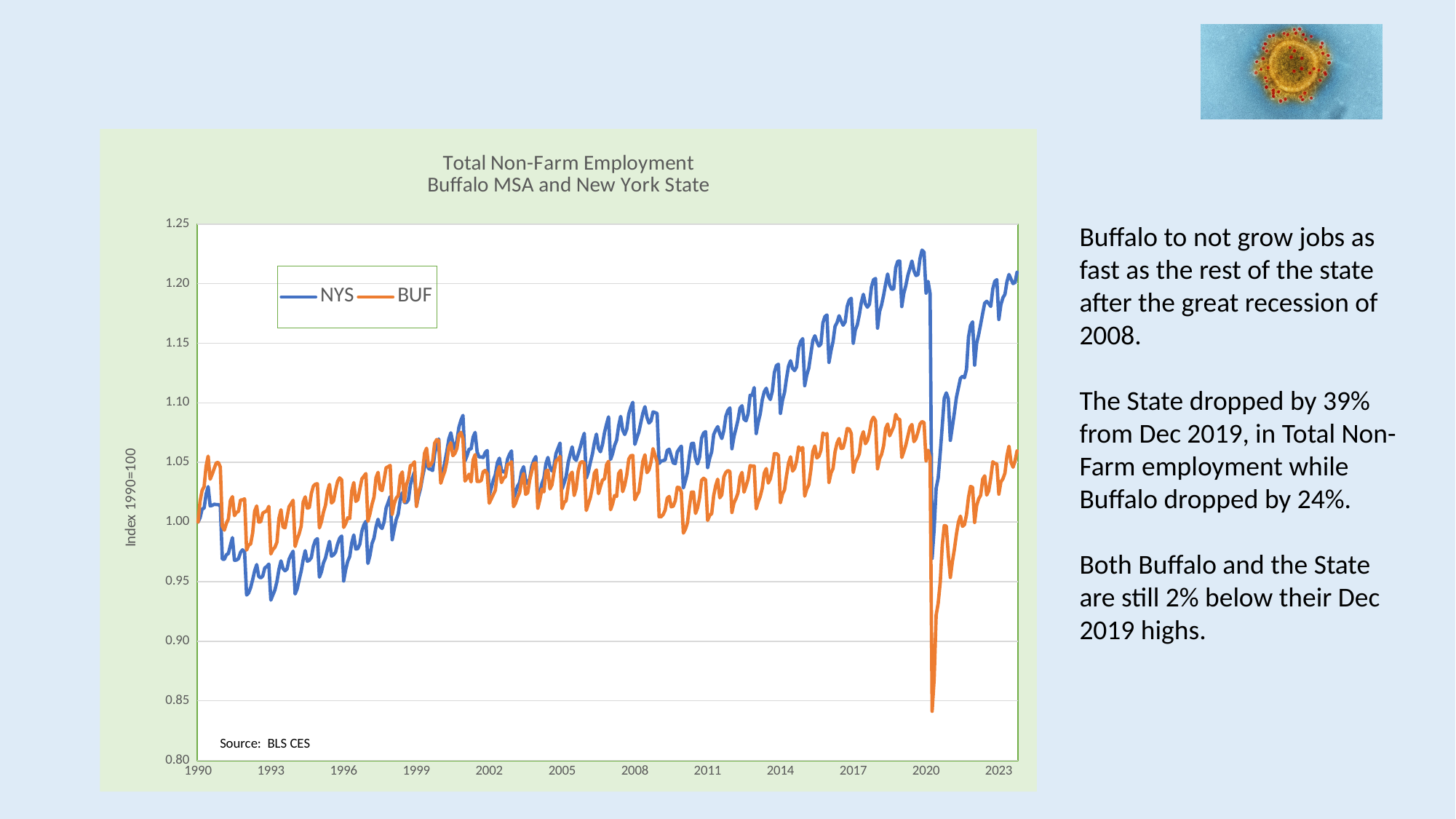
Is the NYS value at the end of the series in 2023 greater or less than 1.15? greater What is the title of the chart? Total Non-Farm Employment Buffalo MSA and New York State Is the NYS value around 1993 greater or less than 1.00? less What kind of chart is shown on the slide? line chart Which series has the higher value around 1993, NYS or BUF? BUF How many series does the chart's legend list? 2 Is the BUF value at the end of the series in 2023 greater or less than 1.10? less Which series has the higher value in 2023, NYS or BUF? NYS Does the NYS series rise or fall between 2011 and 2019? rise What is the label on the chart's vertical axis? Index 1990=100